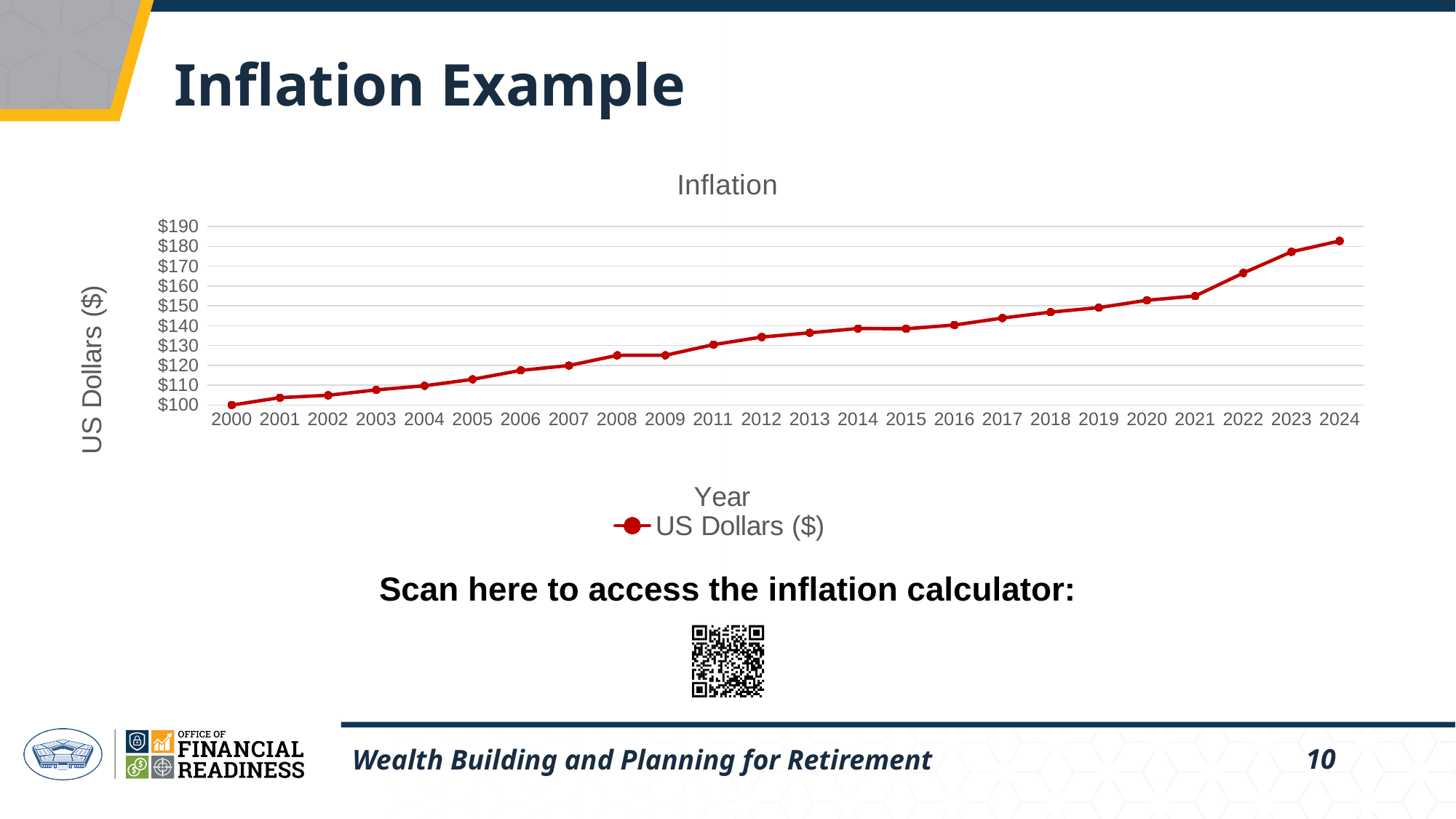
Is the value for 2009 greater or less than $130? less Which is larger, the value for 2022 or the value for 2015? 2022 Which year has the highest value? 2024 What is the value for 2000? $100 How many years are plotted along the x axis? 24 What kind of chart is shown on the slide? line chart Do the values rise or fall from 2000 to 2024? rise Is the value for 2023 greater or less than $170? greater What is the name of the series shown in the legend? US Dollars ($) How many series does the legend list? 1 Which year has the lowest value? 2000 What is the title of the chart? Inflation